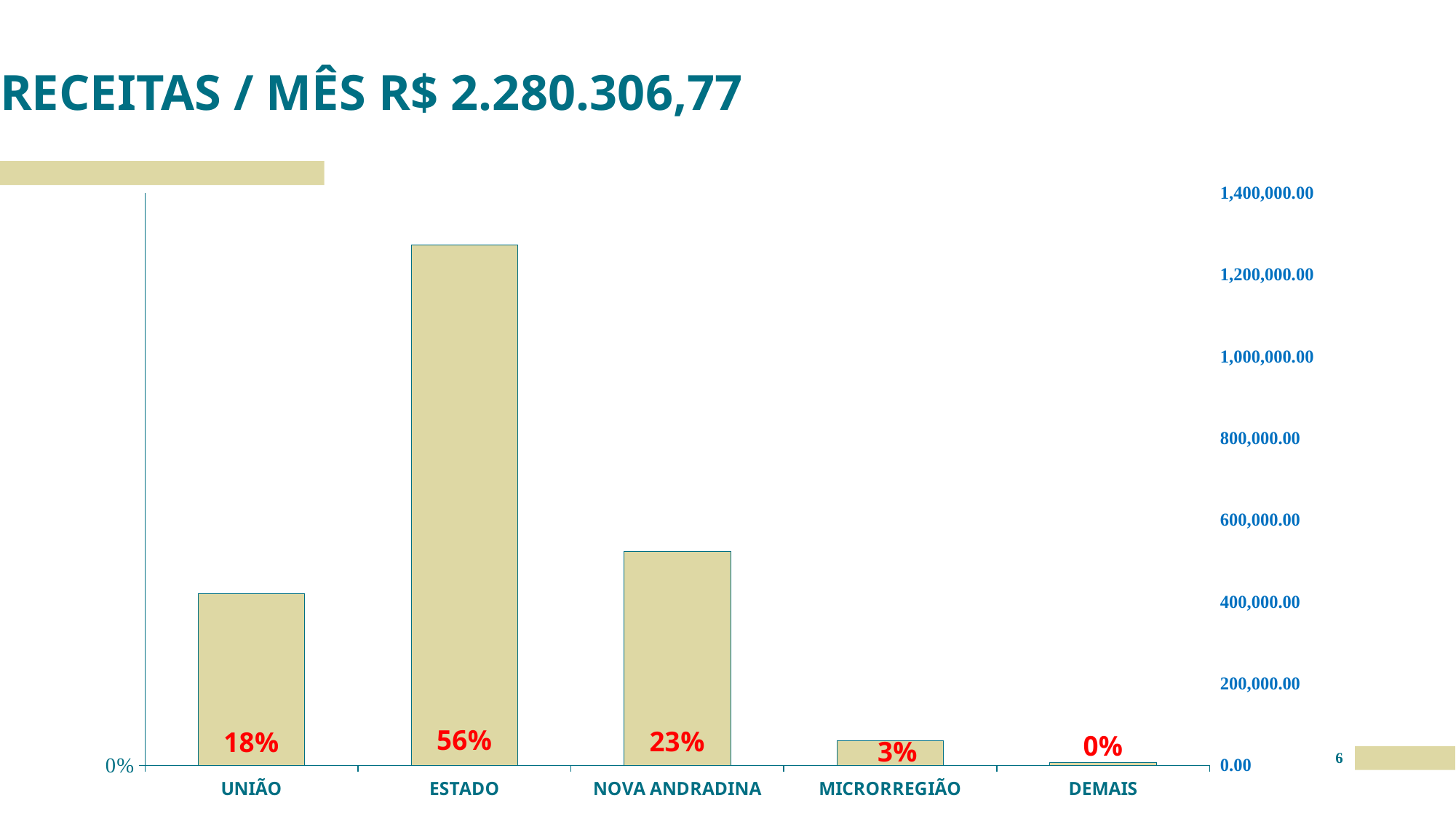
What percentage label is shown on the UNIÃO bar? 18% What is the difference in percentage points between the ESTADO and NOVA ANDRADINA labels? 33% Which category has the highest bar? ESTADO What percentage label is shown on the MICRORREGIÃO bar? 3% Is the value for UNIÃO on the right-hand axis greater or less than 600,000.00? less Which category has the lowest bar? DEMAIS How many categories are shown on the x axis? 5 What percentage label is shown on the NOVA ANDRADINA bar? 23% What type of chart is shown on the slide? Bar chart Is the value for ESTADO on the right-hand axis greater or less than 1,200,000.00? greater What percentage label is shown on the ESTADO bar? 56% Which is larger, the bar for UNIÃO or the bar for NOVA ANDRADINA? NOVA ANDRADINA